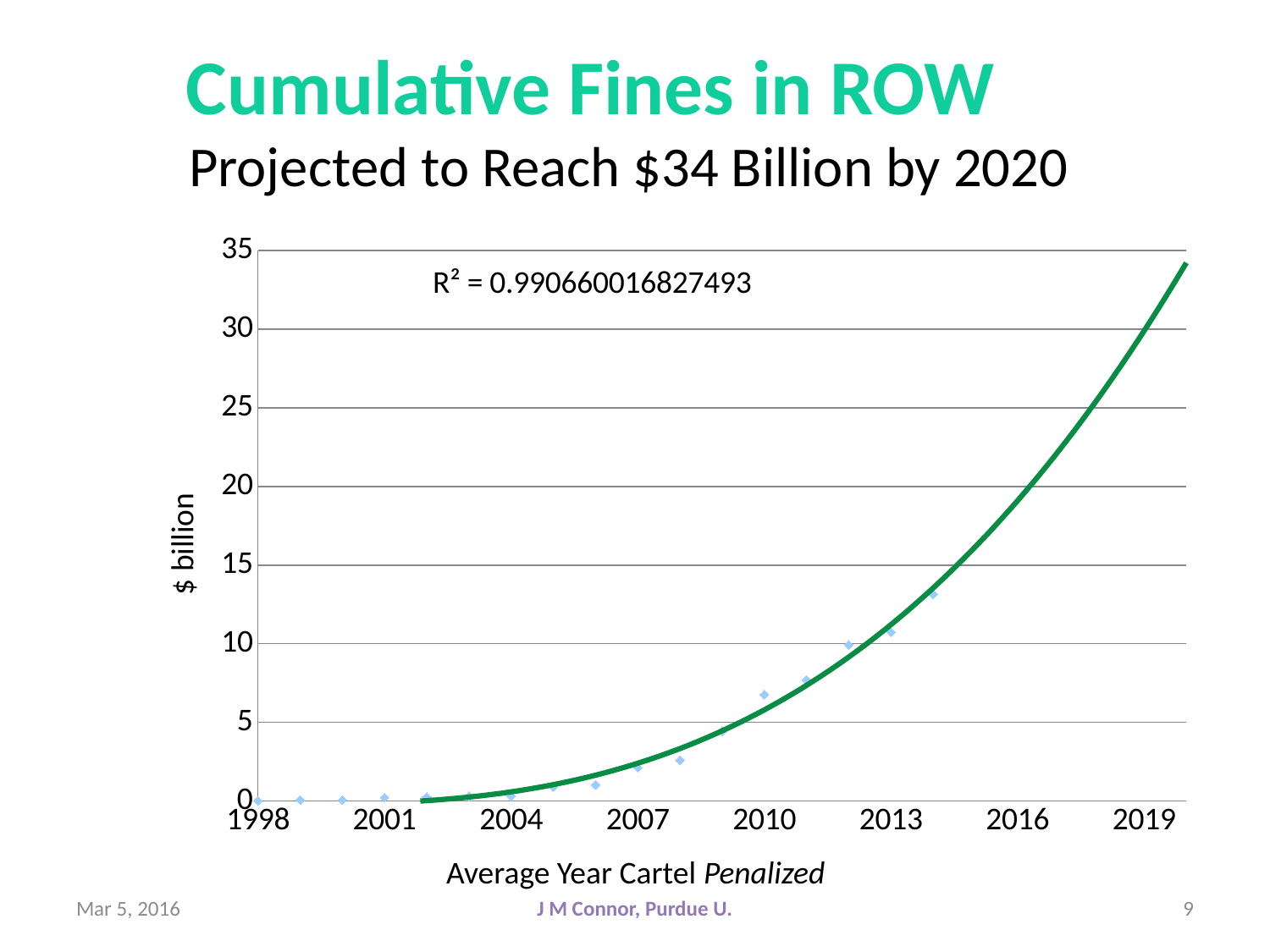
Is the plotted value for 2008 greater or less than 5? less What kind of chart is shown on the slide? scatter chart with a trendline Is the trendline value at 2020 greater or less than 30? greater Is the plotted value for 2010 greater or less than 5? greater Do the plotted cumulative fines rise or fall as the year increases along the x axis? rise What is the title of the chart's y axis? $ billion What R² value is printed on the chart? R² = 0.990660016827493 Is the plotted value for 2014 larger than the plotted value for 2010? yes Which year has the highest plotted cumulative fines value? 2014